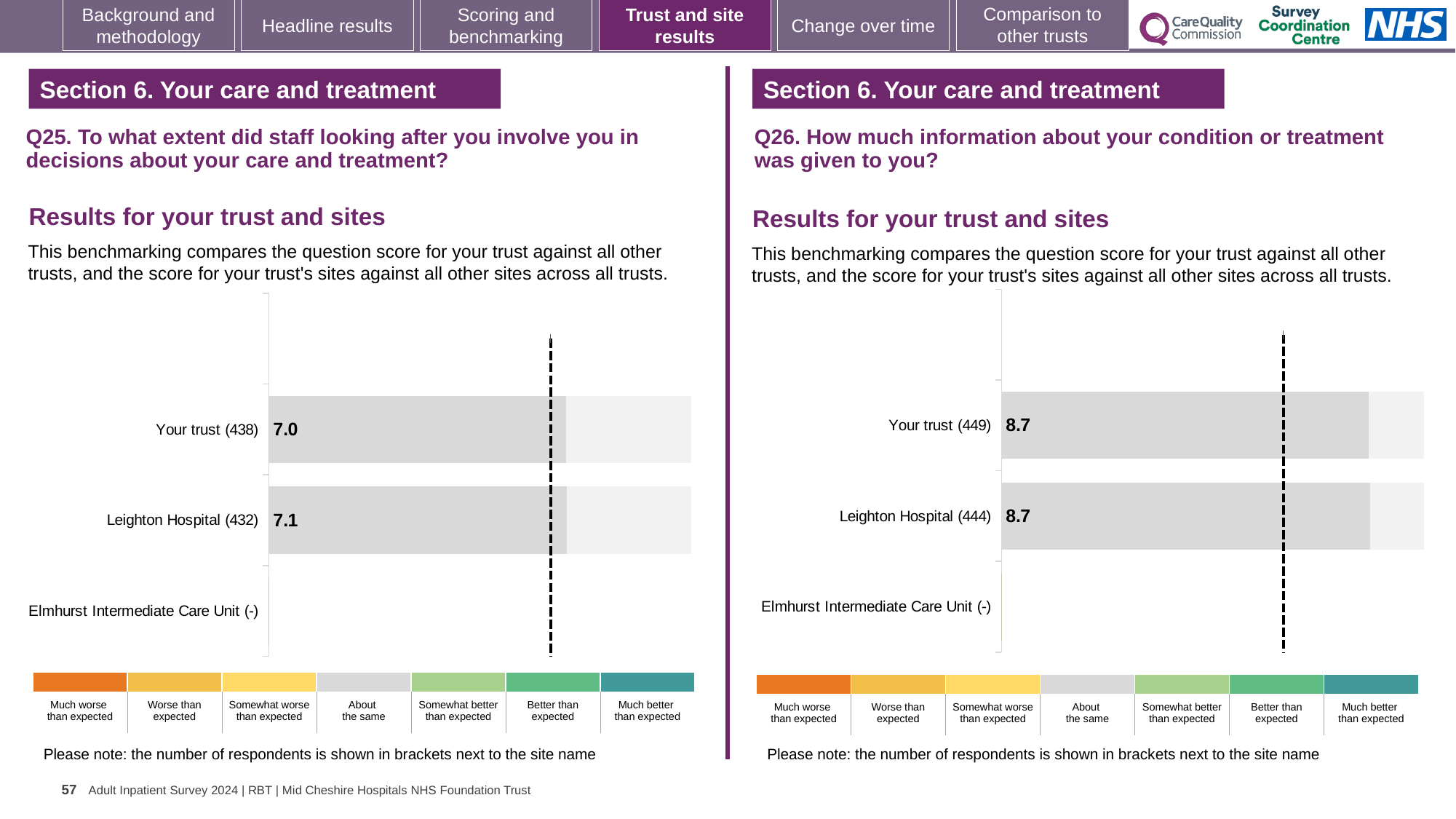
On the Q25 chart (left), what is the difference between the Leighton Hospital score and the Your trust score? 0.1 On the Q26 chart (right), how many respondents are shown in brackets for Your trust? 449 On the Q25 chart (left), what is the score for Your trust? 7.0 On the Q26 chart (right), what is the score for Your trust? 8.7 On the Q25 chart (left), how many respondents are shown in brackets for Your trust? 438 On the Q26 chart (right), how many respondents are shown in brackets for Leighton Hospital? 444 How many categories (sites) are listed on the Q25 chart (left)? 3 What kind of chart is the Q26 chart (right)? Bar chart On the Q26 chart (right), what is the difference between the Your trust score and the Leighton Hospital score? 0.0 On the Q26 chart (right), what is the score for Leighton Hospital? 8.7 On the Q25 chart (left), which site has no score shown? Elmhurst Intermediate Care Unit On the Q25 chart (left), what is the score for Leighton Hospital? 7.1